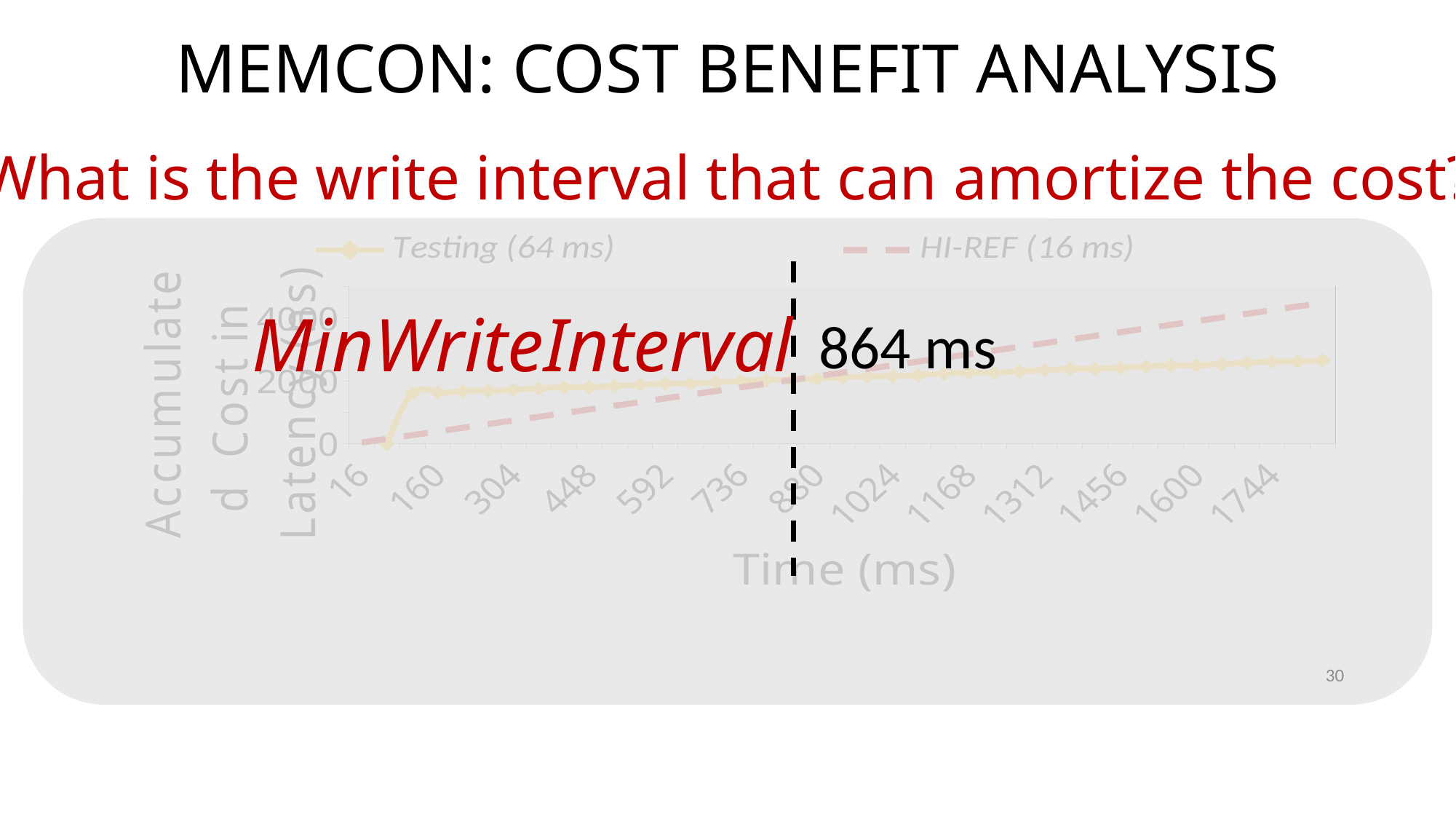
Is the value for Testing (64 ms) at 1744 ms greater or less than 400? greater What MinWriteInterval value is annotated on the chart? 864 ms Does the HI-REF (16 ms) series rise or fall as time increases? rise What are the two series named in the chart legend? Testing (64 ms) and HI-REF (16 ms) At 1744 ms, which series has the higher accumulated cost, Testing (64 ms) or HI-REF (16 ms)? HI-REF (16 ms) Does the Testing (64 ms) series rise or fall as time increases from 160 ms onward? rise Is the value for HI-REF (16 ms) at 1744 ms greater or less than 200? greater How many series does the chart legend list? 2 At 160 ms, which series has the higher accumulated cost, Testing (64 ms) or HI-REF (16 ms)? Testing (64 ms) What kind of chart is shown on the slide? line chart How many tick labels are shown on the Time (ms) axis? 13